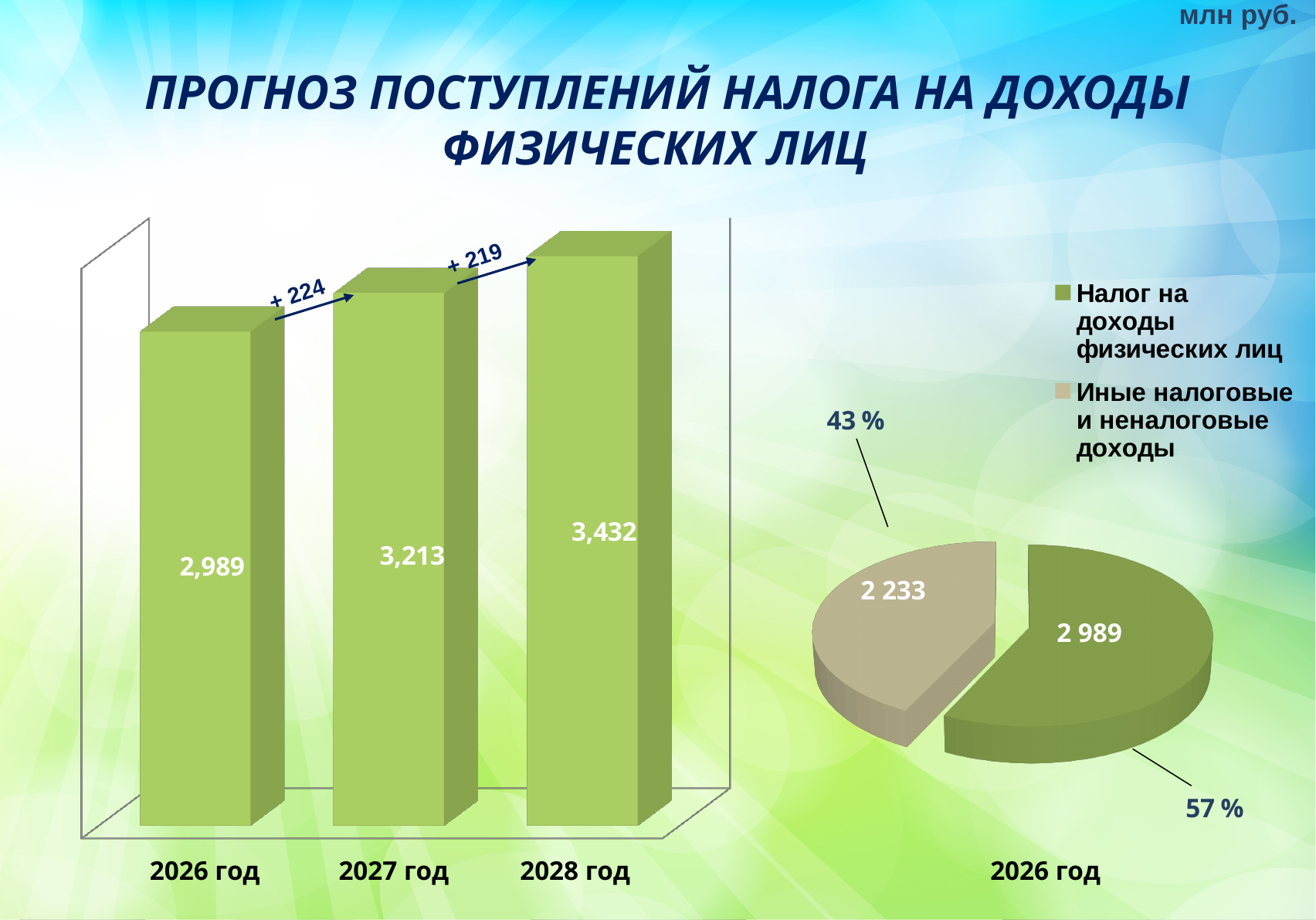
In the bar chart on the left, what is the value for 2028 год? 3,432 In the bar chart on the left, what is the value for 2027 год? 3,213 In the bar chart on the left, how many years are shown? 3 In the pie chart on the right, how many entries does the legend list? 2 What kind of chart is the chart on the left? bar chart In the pie chart on the right, what share of the pie is Налог на доходы физических лиц? 57 % In the bar chart on the left, which year has the lowest value? 2026 год In the bar chart on the left, do the values rise or fall from 2026 год to 2028 год? rise In the bar chart on the left, what is the difference between the values for 2028 год and 2026 год? 443 In the bar chart on the left, what is the difference between the values for 2027 год and 2026 год? 224 In the pie chart on the right, what is the value for Иные налоговые и неналоговые доходы? 2 233 In the bar chart on the left, which year has the highest value? 2028 год